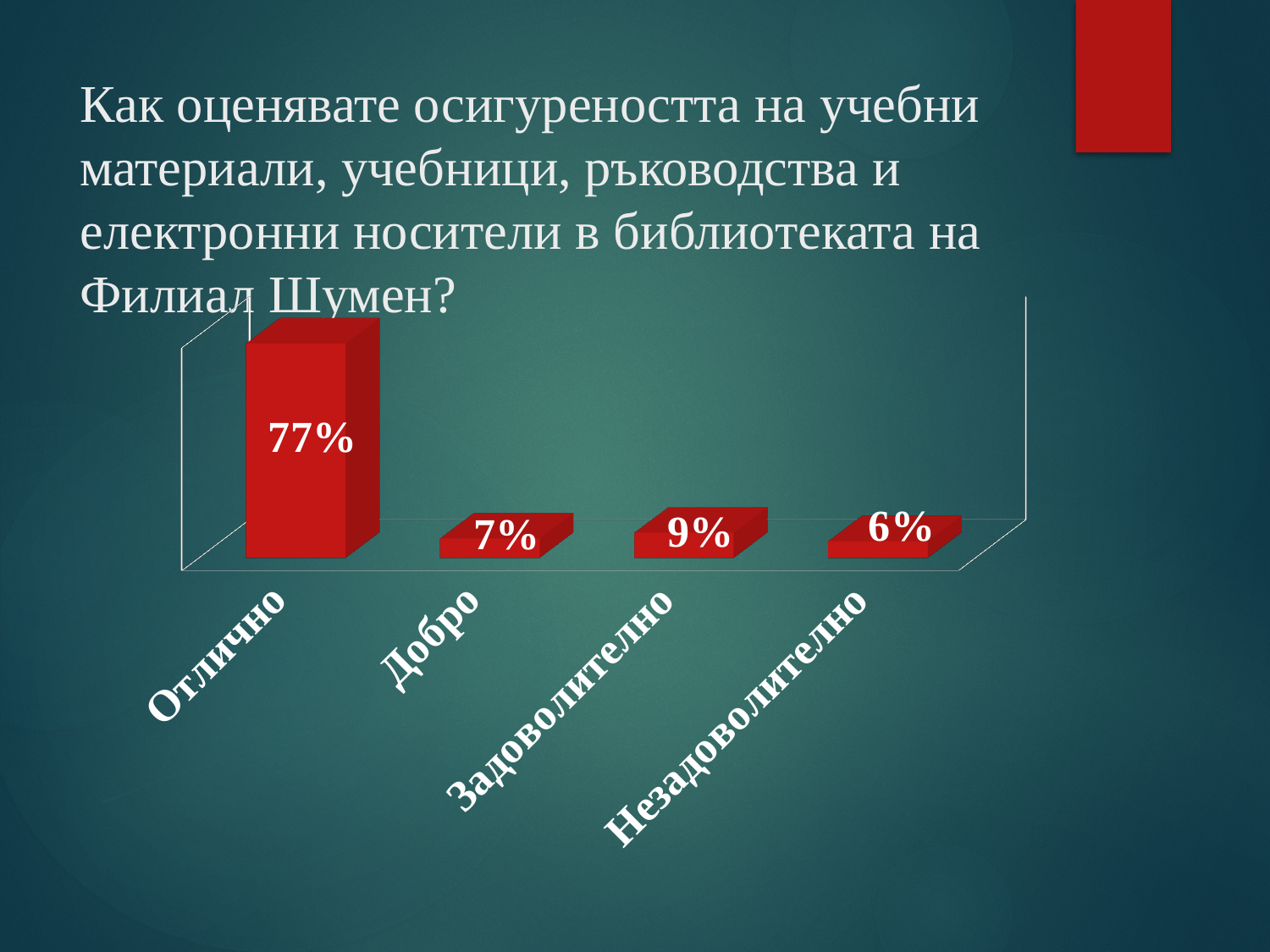
What kind of chart is shown on the slide? Bar chart How many categories are shown in the chart? 4 What is the difference between the values for Задоволително and Добро? 2% What is the value for Добро? 7% What is the difference between the values for Отлично and Задоволително? 68% Which category has the lowest value? Незадоволително What is the value for Задоволително? 9% Which category has the highest value? Отлично What is the value for Незадоволително? 6% What is the value for Отлично? 77% What colour are the bars in the chart? Red Which is larger, the value for Добро or the value for Задоволително? Задоволително